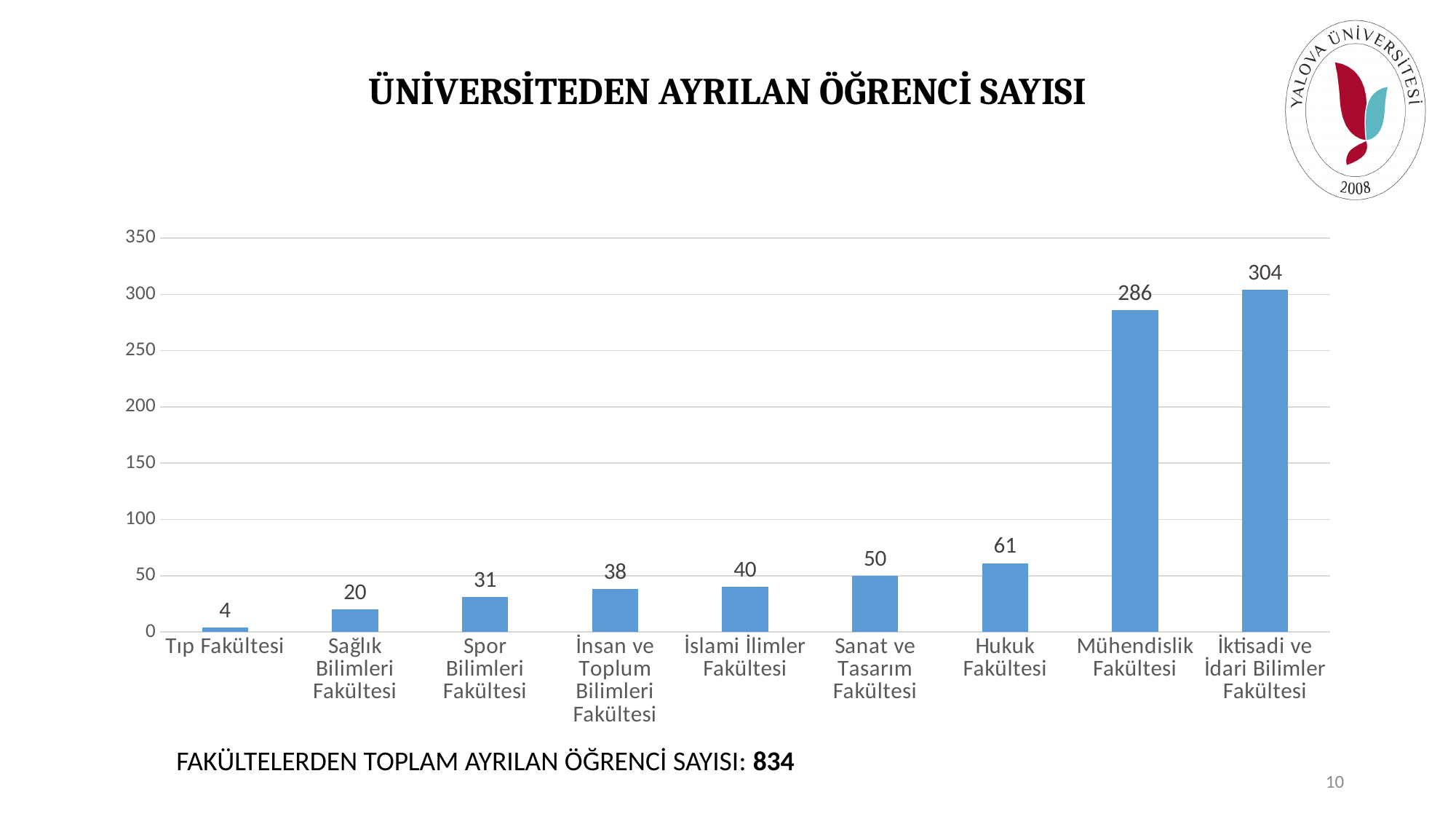
What is the value for Sanat ve Tasarım Fakültesi? 50 What is the difference between the values for İktisadi ve İdari Bilimler Fakültesi and Mühendislik Fakültesi? 18 What is the difference between the values for Hukuk Fakültesi and Sağlık Bilimleri Fakültesi? 41 Which faculty has the highest number of students leaving? İktisadi ve İdari Bilimler Fakültesi What is the title of the chart? ÜNİVERSİTEDEN AYRILAN ÖĞRENCİ SAYISI Which is larger, the value for İslami İlimler Fakültesi or the value for Spor Bilimleri Fakültesi? İslami İlimler Fakültesi How many faculties are shown on the chart? 9 Which faculty has the lowest number of students leaving? Tıp Fakültesi What is the value for Mühendislik Fakültesi? 286 Is the value for Hukuk Fakültesi greater or less than 50? greater What kind of chart is shown on the slide? bar chart What is the value for Tıp Fakültesi? 4